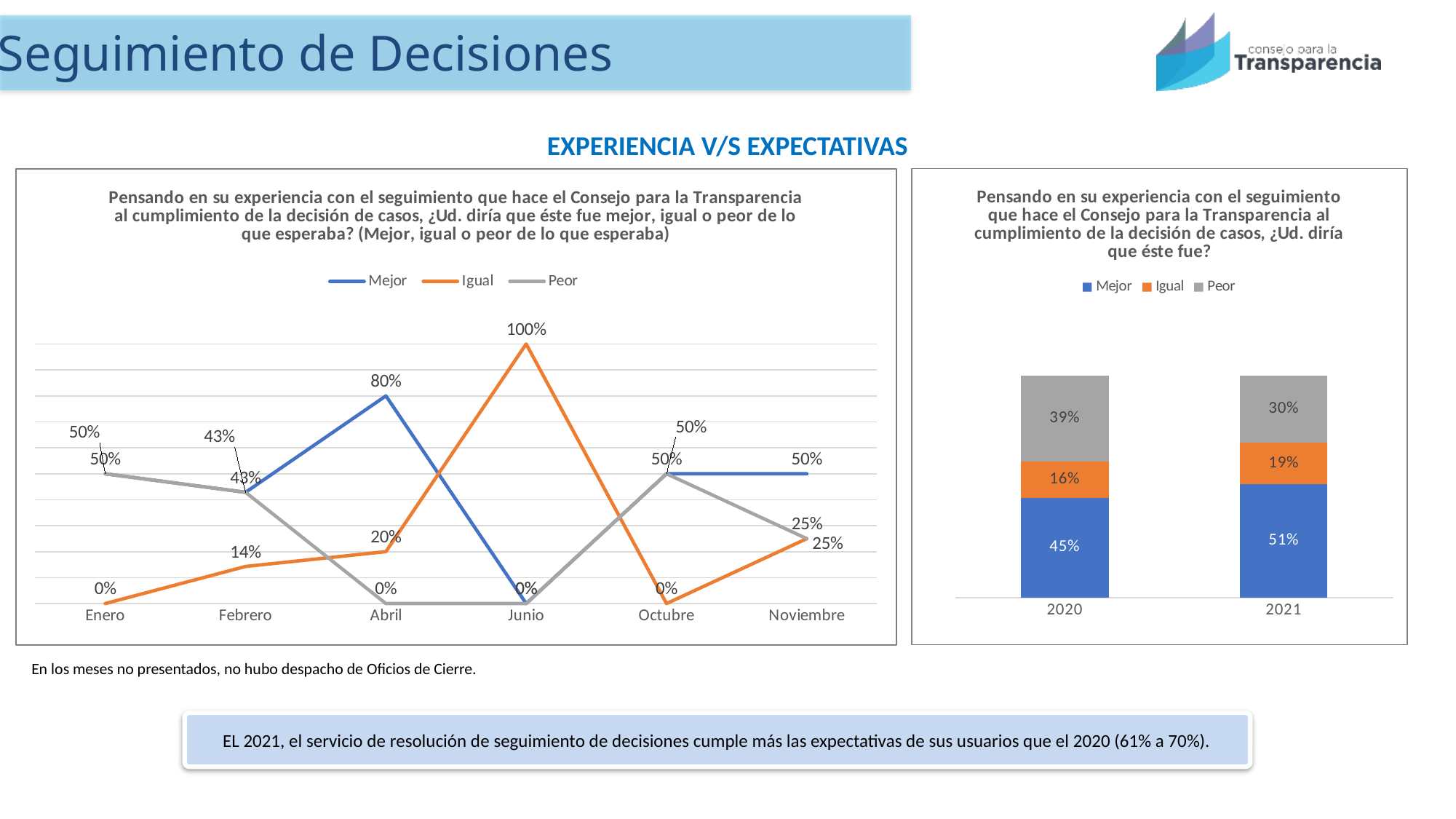
In the right chart (stacked bars by year), what is the value for Peor in 2020? 39% In the right chart (stacked bars by year), which year has the larger Mejor value, 2020 or 2021? 2021 How many months are shown on the x axis of the left chart (line chart by month)? 6 In the right chart (stacked bars by year), what is the difference between the Peor value in 2020 and in 2021? 9 percentage points In the left chart (line chart by month), in which month does the Igual series reach its highest value? Junio In the right chart (stacked bars by year), what is the value for Mejor in 2021? 51% What kind of chart is the right chart on the slide? Stacked bar chart What kind of chart is the left chart on the slide? Line chart How many series does the legend of the left chart (line chart by month) list? 3 In the left chart (line chart by month), what is the value for Mejor in Abril? 80% In the left chart (line chart by month), what is the value for Igual in Febrero? 14% In the left chart (line chart by month), what is the value for Igual in Junio? 100%